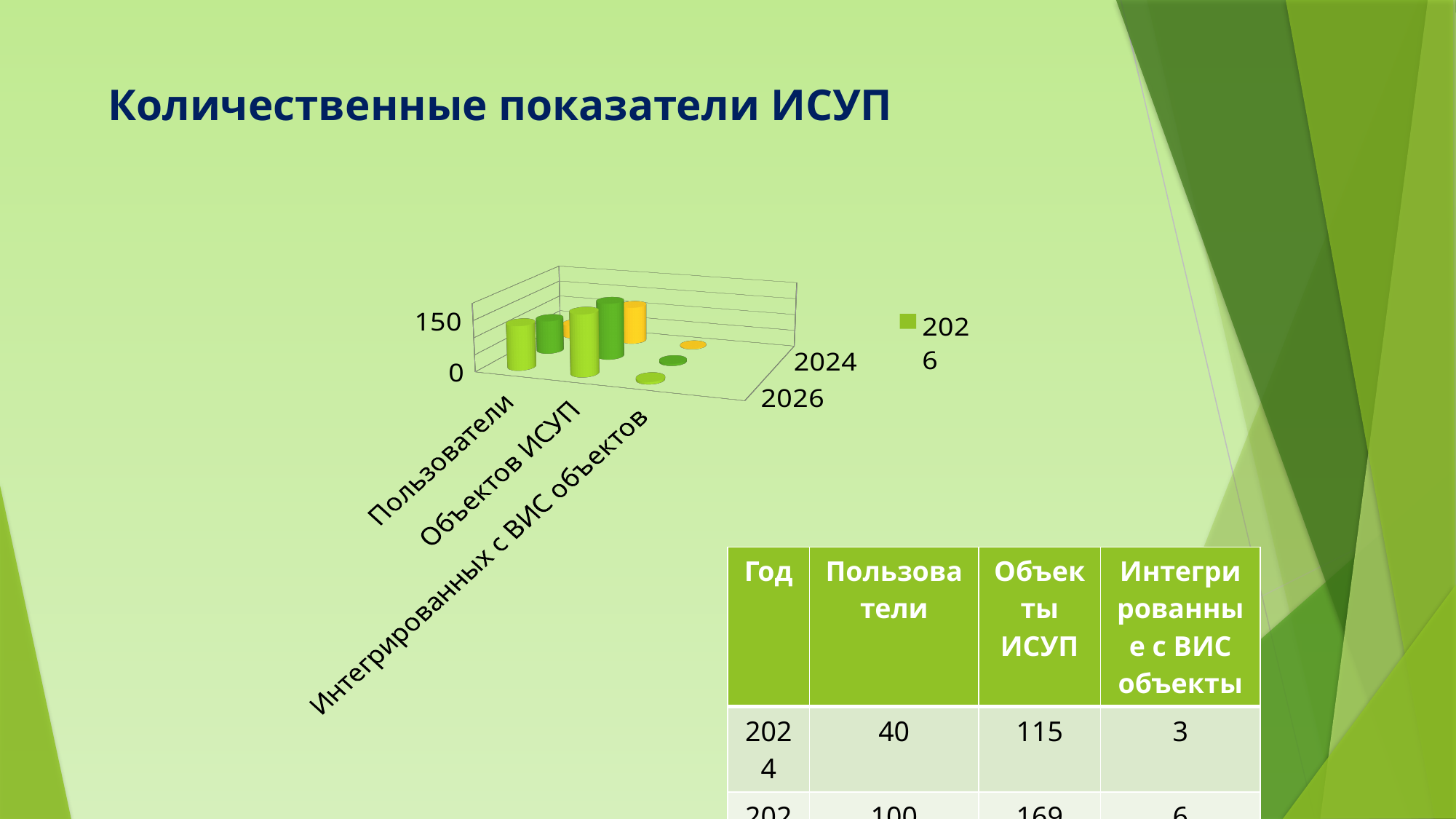
What is the highest tick value shown on the chart's value axis? 150 What is the title of the slide containing the chart? Количественные показатели ИСУП According to the table on the slide, what is the difference between Объекты ИСУП and Пользователи in 2024? 75 Which category has the lowest values in the chart? Интегрированных с ВИС объектов Are the values for Интегрированных с ВИС объектов greater or less than 150? less How many categories are shown along the category axis of the chart? 3 According to the table on the slide, how many Интегрированные с ВИС объекты were there in 2024? 3 What kind of chart is shown on the slide? bar chart Which category has larger values in the chart: Объектов ИСУП or Интегрированных с ВИС объектов? Объектов ИСУП According to the table on the slide, how many Объекты ИСУП were there in 2024? 115 According to the table on the slide, how many Пользователи were there in 2024? 40